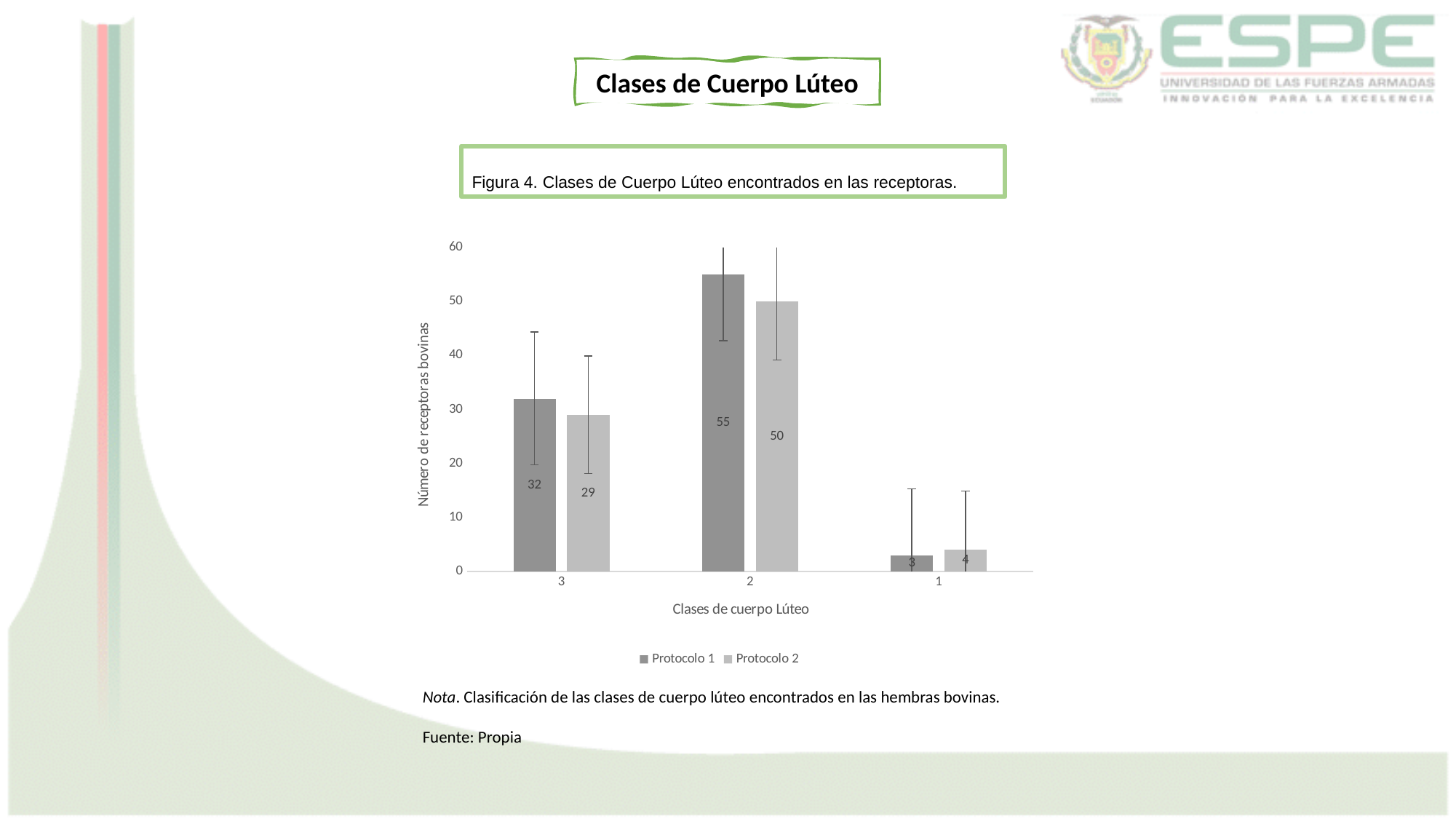
Is the value for Protocolo 2 in class 2 greater or less than 40? greater What is the value for Protocolo 1 in class 2? 55 Which class has the highest value for Protocolo 1? 2 How many series does the legend list? 2 What is the difference between Protocolo 1 in class 3 and Protocolo 1 in class 1? 29 Which is larger in class 3, Protocolo 1 or Protocolo 2? Protocolo 1 What is the difference between Protocolo 1 and Protocolo 2 in class 2? 5 What kind of chart is shown? bar chart What is the value for Protocolo 2 in class 1? 4 How many classes are shown on the x axis? 3 Which class has the lowest value for Protocolo 2? 1 What is the value for Protocolo 2 in class 3? 29